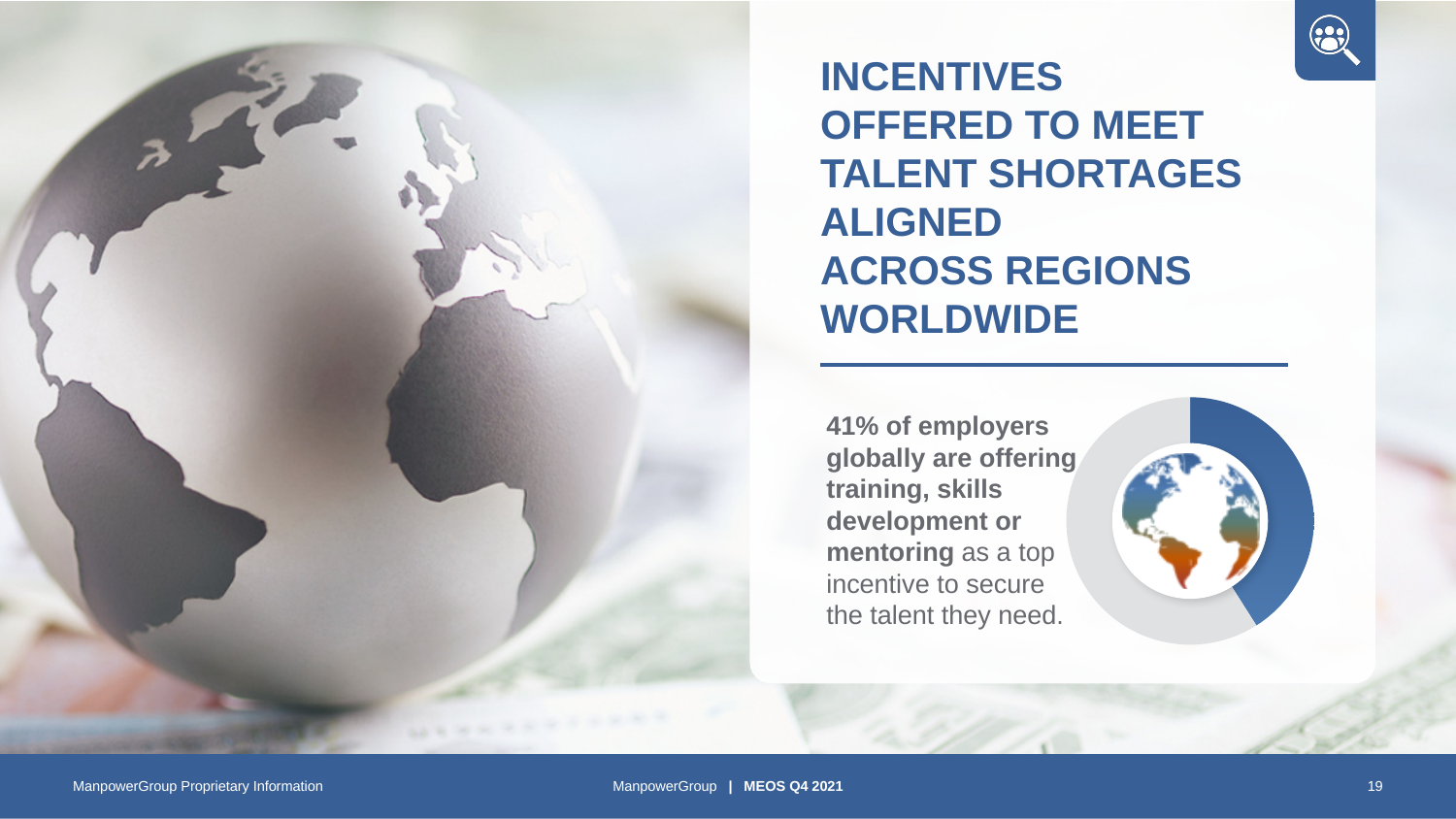
How many segments does the donut chart have? 2 What share of employers globally are offering training, skills development or mentoring, according to the chart? 41% Is the blue segment of the donut chart greater or less than 50%? less What colour is the segment representing the 41% of employers? Blue What image is shown in the centre of the donut chart? A globe What share of the donut chart does the grey segment represent? 59% Which segment of the donut chart is larger, the blue one or the grey one? the grey one What kind of chart is shown on the slide? Donut (pie) chart